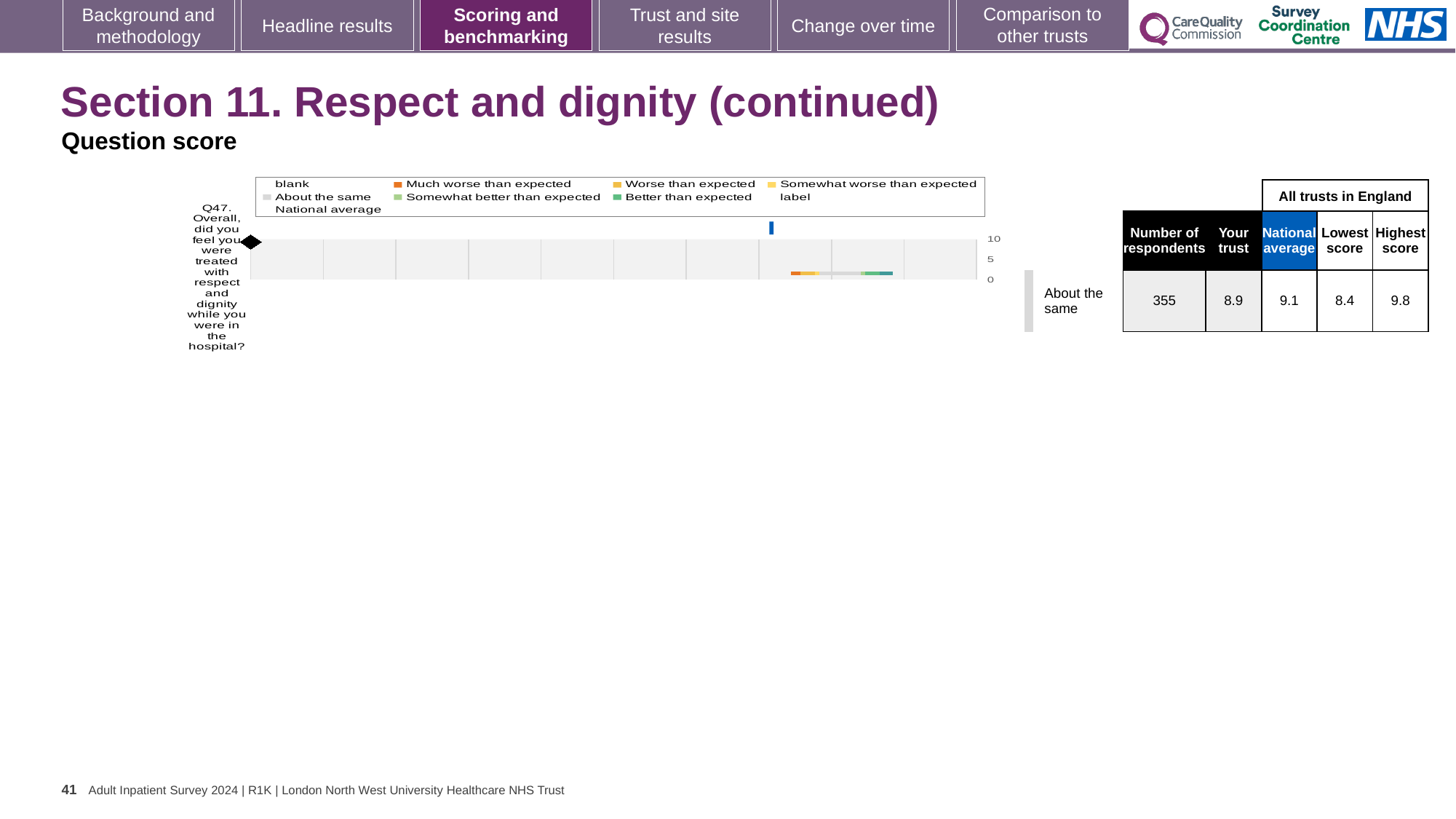
What is the lowest score among all trusts in England for Q47? 8.4 What is the 'Your trust' score for Q47? 8.9 How many respondents answered Q47? 355 What is the difference between the national average and the 'Your trust' score for Q47? 0.2 What is the national average score for Q47? 9.1 How many questions (categories) are plotted on the chart? 1 What benchmark category is the trust's Q47 score placed in? About the same Which question is plotted on the chart? Q47. Overall, did you feel you were treated with respect and dignity while you were in the hospital? What is the highest value shown on the chart's axis? 10 What is the highest score among all trusts in England for Q47? 9.8 Which is larger for Q47, the 'Your trust' score or the national average? National average What kind of chart is shown on the slide? bar chart